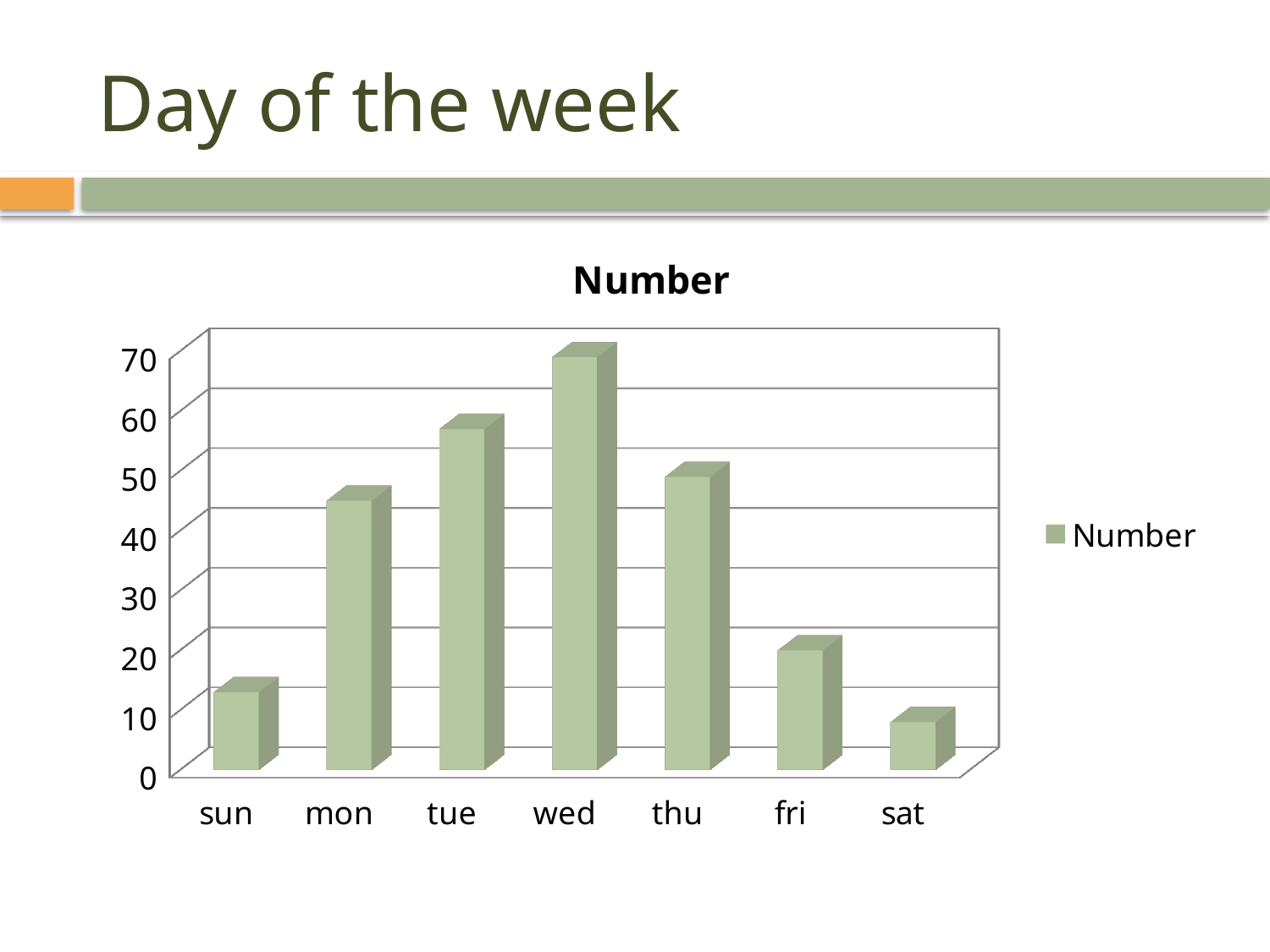
Which day has the lowest value in the chart? sat What is the title of the chart? Number How many days (categories) are shown on the x axis of the chart? 7 How many series does the chart's legend list? 1 Which has the larger value, tue or thu? tue Is the value for wed greater or less than 60? greater What kind of chart is shown on the slide? bar chart Is the value for fri greater or less than 30? less Which day has the highest value in the chart? wed Is the value for sun greater or less than 20? less Which has the larger value, mon or fri? mon